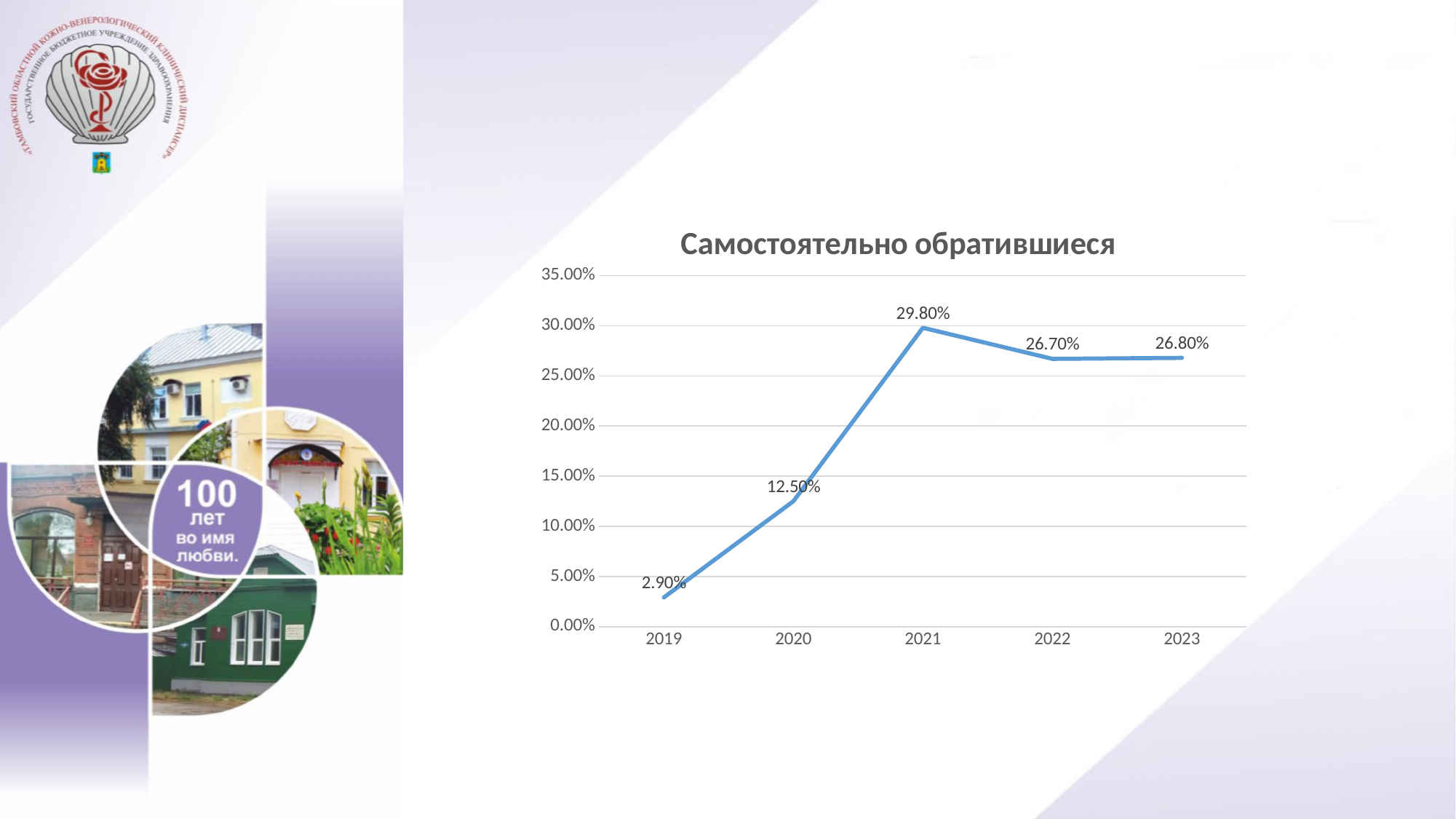
Which year has the highest value? 2021 Which is larger, the value for 2021 or the value for 2022? 2021 What is the value for 2023? 26.80% How many years are plotted on the chart? 5 What is the title of the chart? Самостоятельно обратившиеся What is the value for 2021? 29.80% What is the value for 2019? 2.90% What kind of chart is shown? line chart What is the difference between the values for 2020 and 2019? 9.60% What is the difference between the values for 2021 and 2020? 17.30% Which year has the lowest value? 2019 Is the value for 2020 greater or less than 10.00%? greater